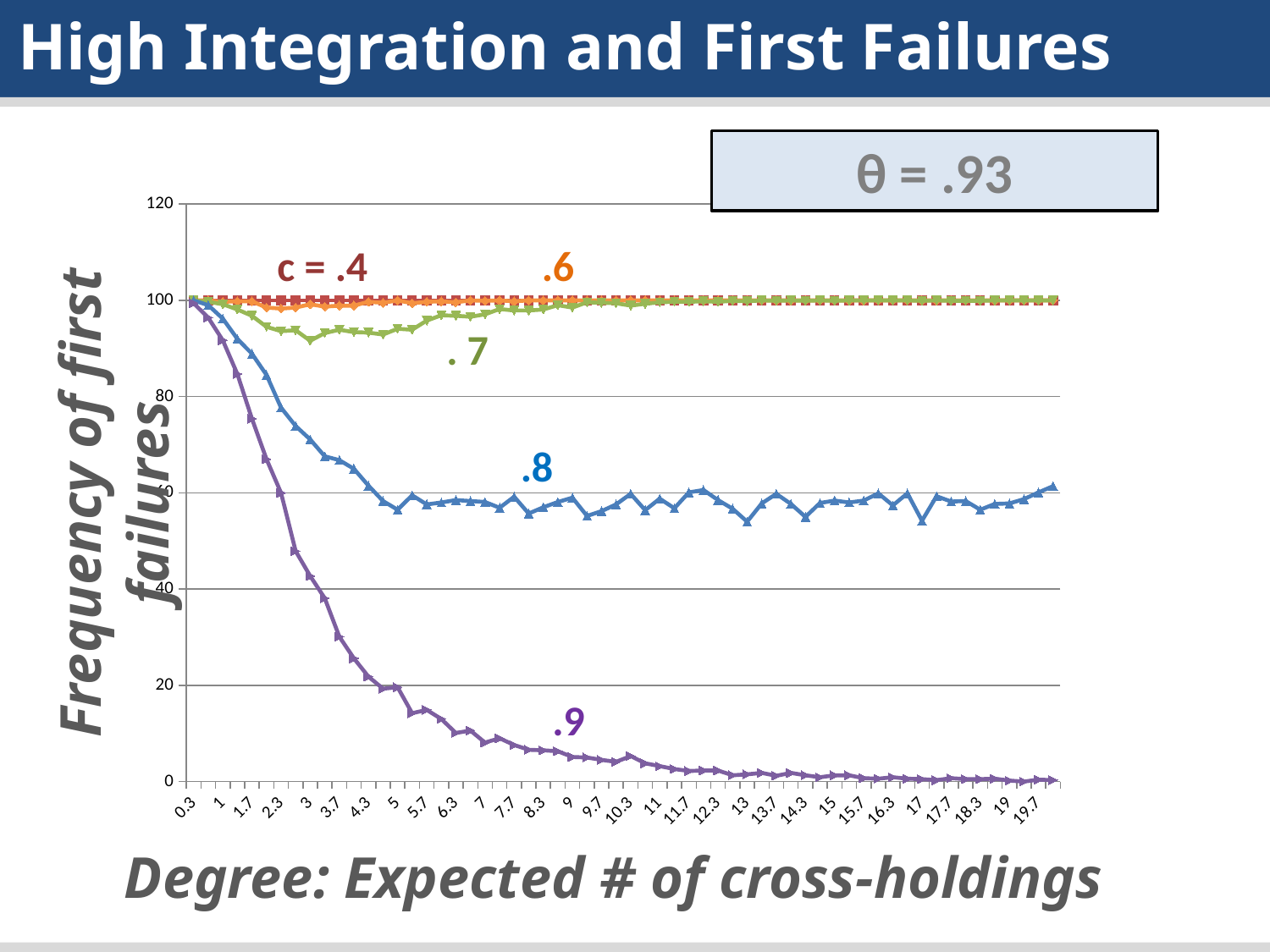
What is the x-axis label of the chart? Degree: Expected # of cross-holdings How many series (values of c) are plotted on the chart? 5 What kind of chart is shown on the slide? line chart Is the value for the .9 series at a degree of 13 greater or less than 20? less Does the .9 series rise or fall as the degree increases from 0.3 to 10.3? fall Is the value for the .8 series at a degree of 10.3 greater or less than 80? less At a degree of 5, which series has the larger value: .8 or .9? .8 Is the value for the .7 series at a degree of 3 greater or less than 80? greater Which series has the highest frequency of first failures at a degree of 19.7? c = .4, .6 and .7 (all tied at 100) Which series has the lowest frequency of first failures at a degree of 19.7? .9 What is the value of θ shown in the box on the slide? θ = .93 What is the title of the slide containing the chart? High Integration and First Failures